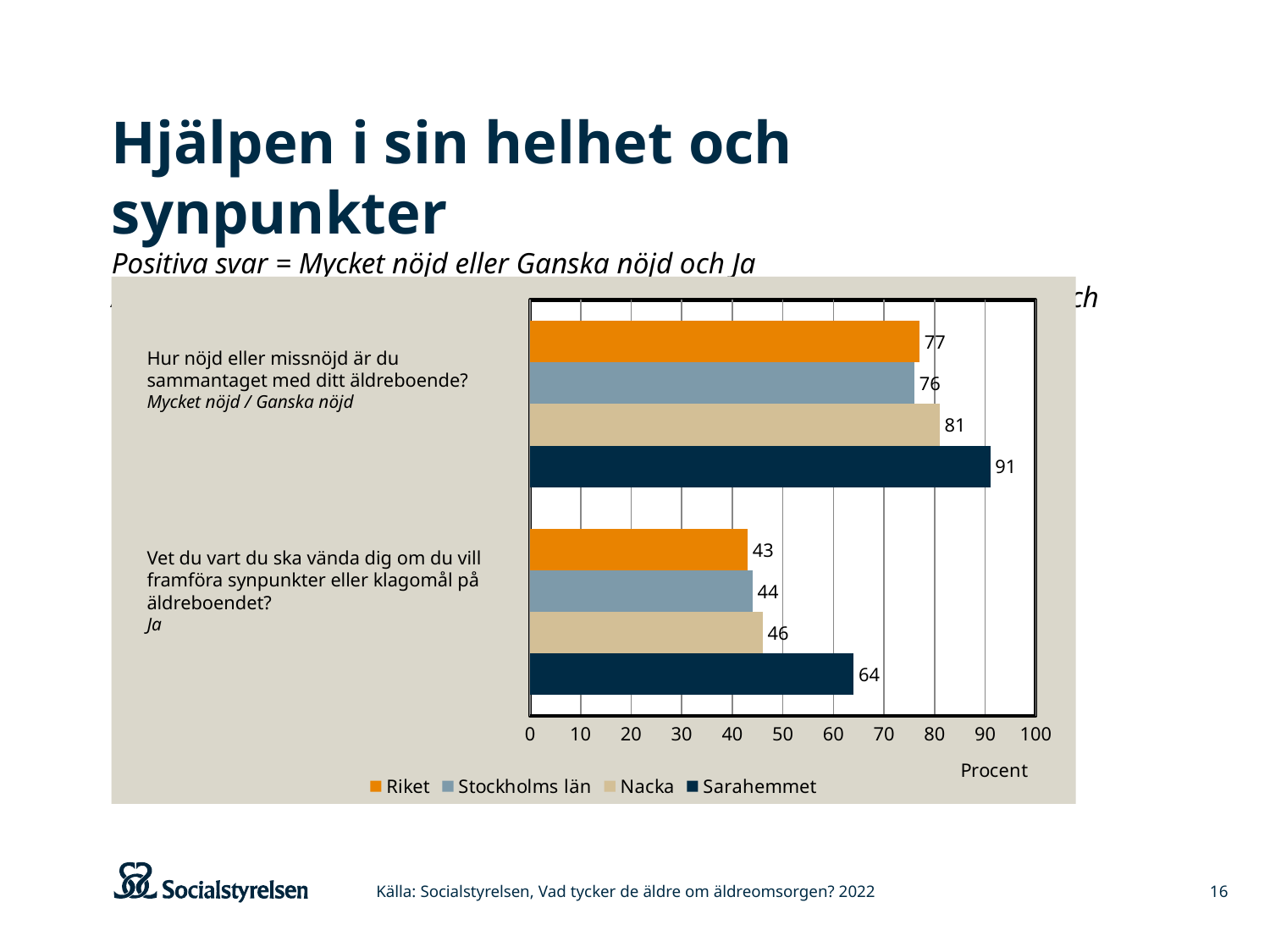
Which is larger: Nacka's value for overall satisfaction or Nacka's value for knowing where to turn with complaints? Overall satisfaction (81) What value does Riket have for the question about knowing where to turn to give feedback or complaints (Vet du vart du ska vända dig...)? 43 What value does Stockholms län have for the question about knowing where to turn with feedback or complaints? 44 What value does Nacka have for the question about overall satisfaction with the elderly home? 81 How many series does the legend list? 4 Which series has the highest value for the question about knowing where to turn with feedback or complaints? Sarahemmet What kind of chart is shown on the slide? Bar chart What is the label on the horizontal axis of the chart? Procent What is the difference between Sarahemmet and Nacka for the question about knowing where to turn with feedback or complaints? 18 What is the difference between Sarahemmet and Riket for the question about overall satisfaction with the elderly home? 14 What value does Sarahemmet have for the question about how satisfied residents are overall with their elderly home (Hur nöjd eller missnöjd är du sammantaget med ditt äldreboende?)? 91 Which series has the lowest value for the question about overall satisfaction with the elderly home? Stockholms län